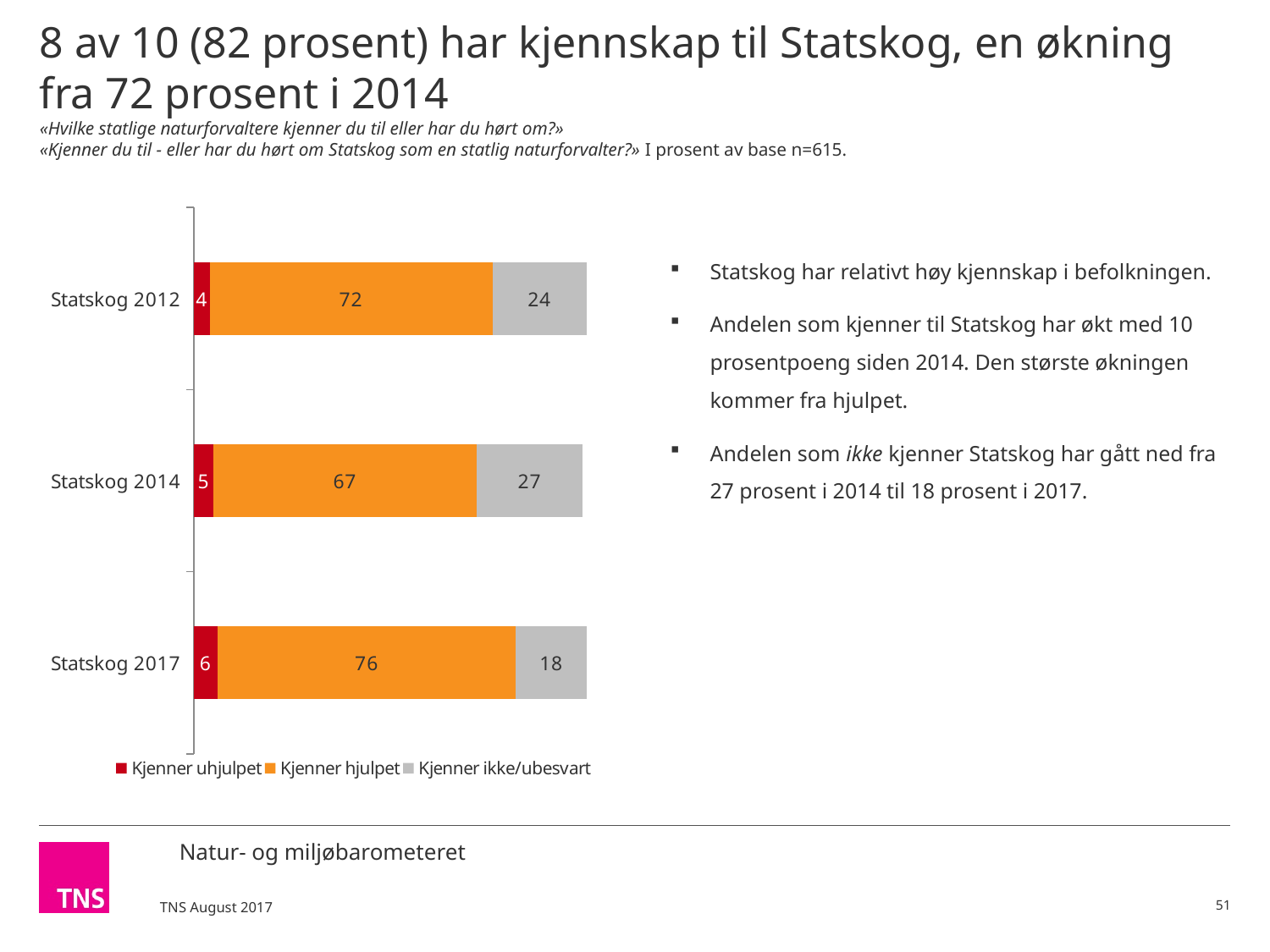
What is the value for Kjenner uhjulpet for Statskog 2012? 4 What is the difference between the Kjenner hjulpet values for Statskog 2017 and Statskog 2014? 9 What kind of chart is shown on the slide? Stacked bar chart How many categories are shown on the chart? 3 Which category has the highest value for Kjenner hjulpet? Statskog 2017 Which series is shown in orange in the legend? Kjenner hjulpet What is the total of the stacked bar for Statskog 2014? 99 How many series does the legend list? 3 Which is larger: Kjenner ikke/ubesvart for Statskog 2012 or for Statskog 2014? Statskog 2014 Which category has the lowest value for Kjenner ikke/ubesvart? Statskog 2017 What is the value for Kjenner hjulpet for Statskog 2017? 76 What is the value for Kjenner ikke/ubesvart for Statskog 2014? 27